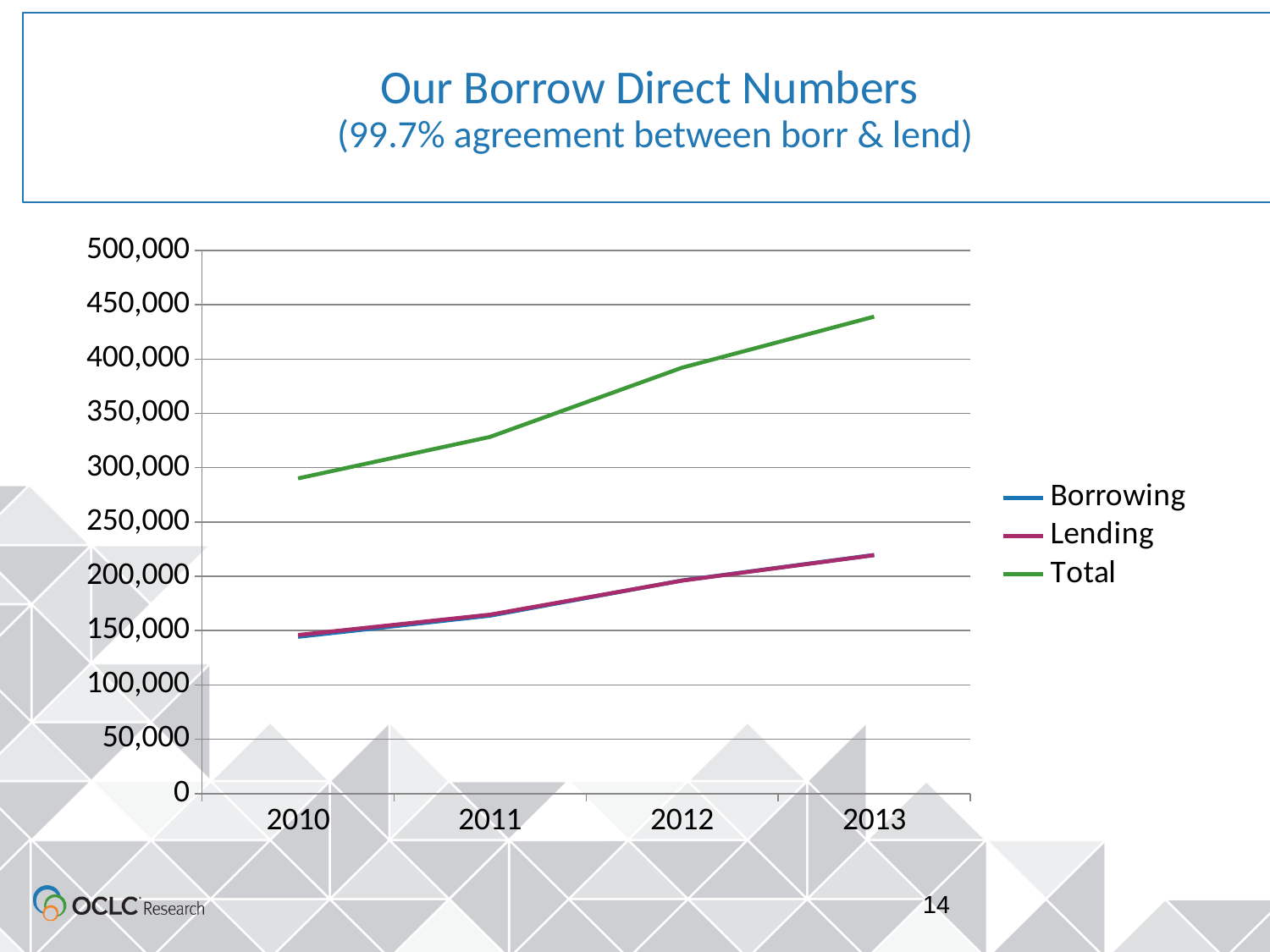
Is the value for Total in 2013 greater or less than 400,000? greater Is the value for Total in 2010 greater or less than 300,000? less In which year is the Total series at its lowest? 2010 What colour is the Total series line in the legend? green Is the value for Lending in 2013 greater or less than 200,000? greater Does the Total series rise or fall from 2010 to 2013? rise In which year is the Total series at its highest? 2013 Which is larger in 2013, the Total series or the Lending series? Total How many series does the legend list? 3 How many years are plotted along the x axis? 4 What kind of chart is shown on the slide? line chart